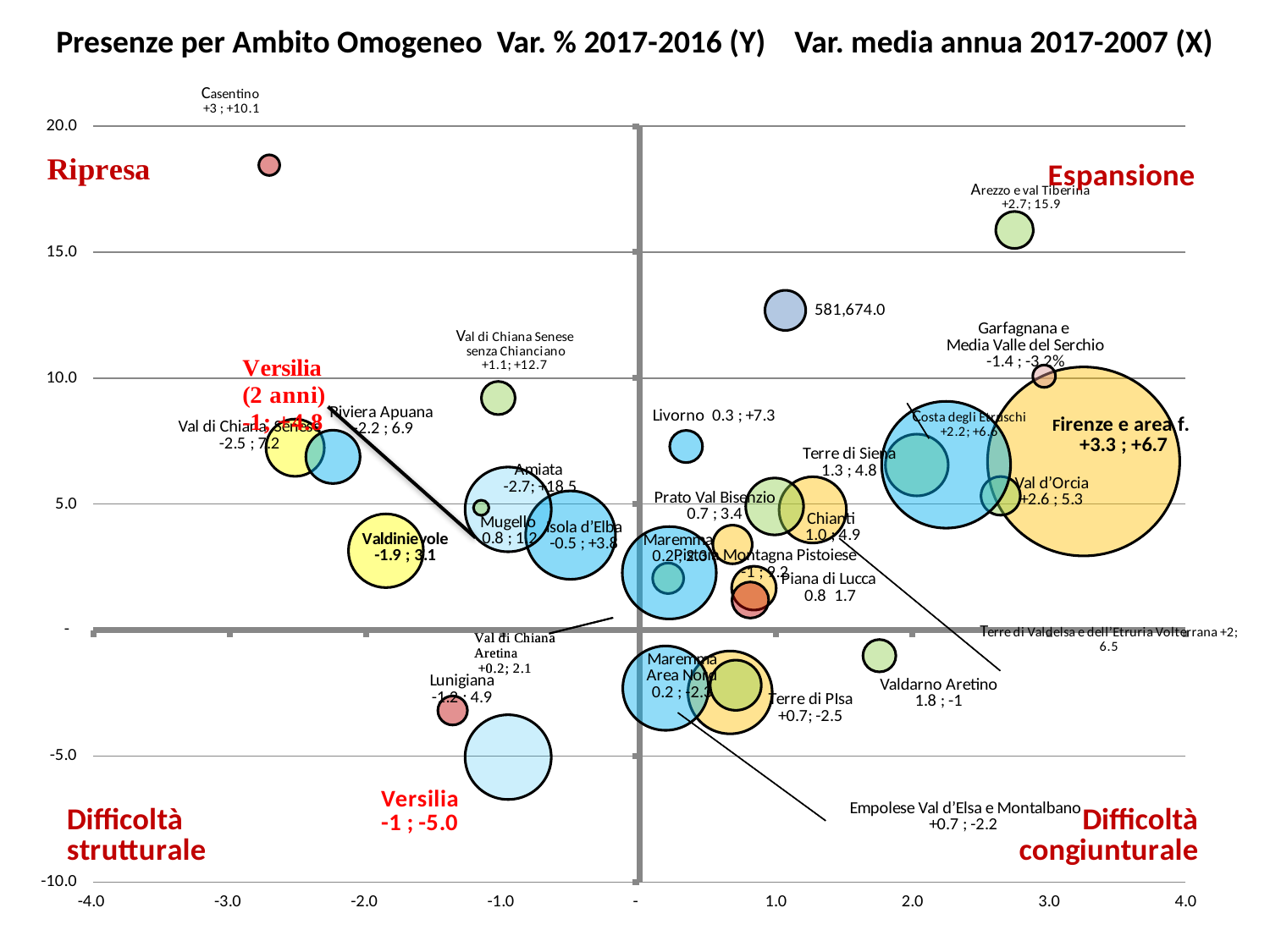
What kind of chart is shown on the slide? Bubble chart What values are printed next to the label 'Arezzo e val Tiberina'? +2.7; 15.9 What values are printed next to the label 'Livorno'? 0.3 ; +7.3 What values are printed next to the label 'Terre di Pisa'? +0.7; -2.5 What values are printed next to the label 'Valdarno Aretino'? 1.8 ; -1 What label is written in the upper-right quadrant of the chart? Espansione What values are printed next to the label 'Valdinievole'? -1.9 ; 3.1 What values are printed next to the label 'Versilia' in the lower-left quadrant? -1 ; -5.0 Which has the larger second (Y) value printed on its label, 'Arezzo e val Tiberina' or 'Riviera Apuana'? Arezzo e val Tiberina What is the highest value shown on the vertical axis? 20.0 What values are printed next to the label 'Firenze e area f.'? +3.3 ; +6.7 What values are printed next to the label 'Empolese Val d'Elsa e Montalbano'? +0.7 ; -2.2